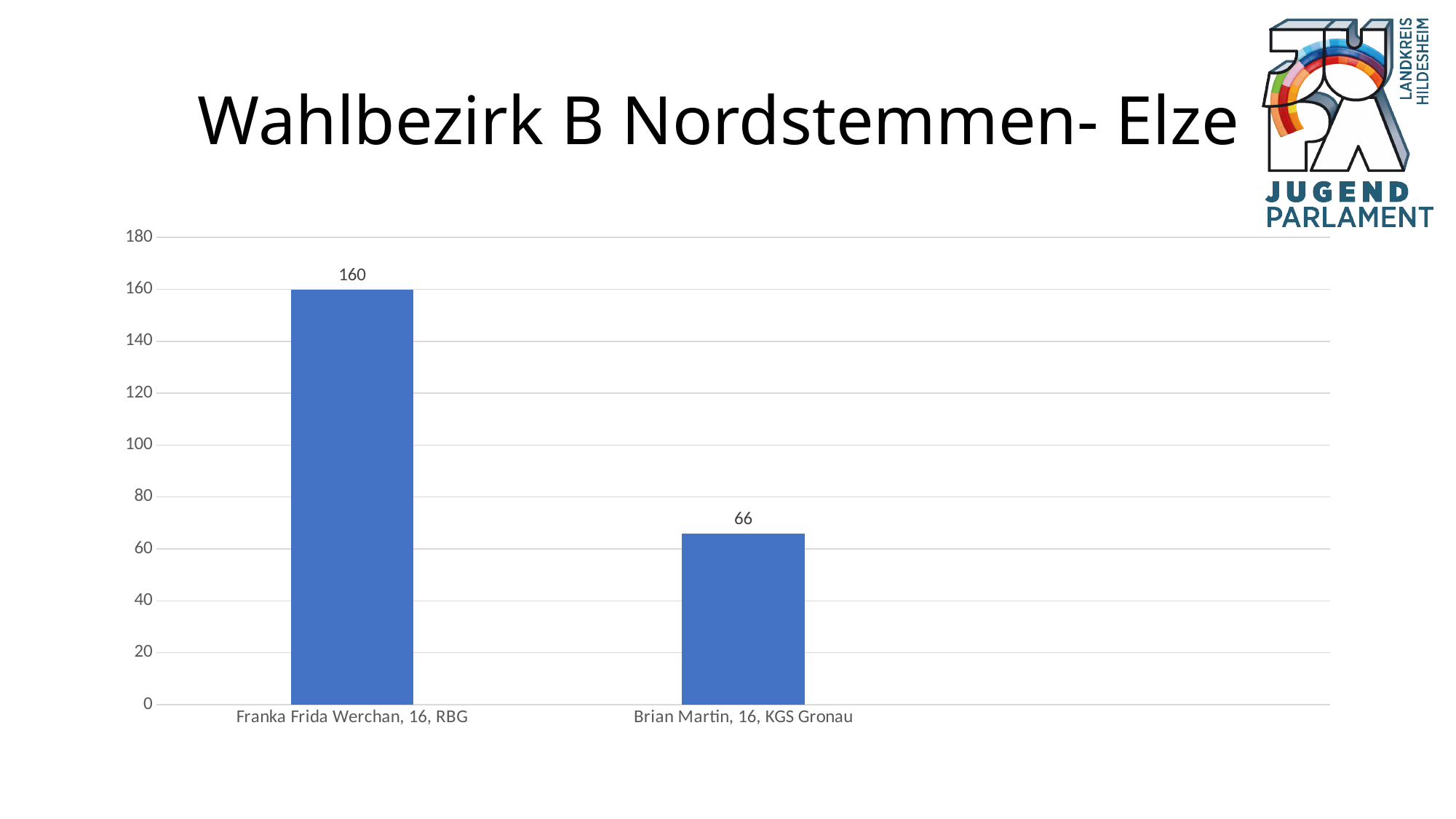
What is the difference between the values for Franka Frida Werchan, 16, RBG and Brian Martin, 16, KGS Gronau? 94 Which category has the lowest value? Brian Martin, 16, KGS Gronau Is the value for Brian Martin, 16, KGS Gronau greater or less than 80? less Is the value for Franka Frida Werchan, 16, RBG greater or less than 140? greater What kind of chart is shown on the slide? bar chart What is the value for Franka Frida Werchan, 16, RBG? 160 How many categories are shown in the chart? 2 Which is larger, the value for Franka Frida Werchan, 16, RBG or the value for Brian Martin, 16, KGS Gronau? Franka Frida Werchan, 16, RBG What is the value for Brian Martin, 16, KGS Gronau? 66 What is the title of the slide? Wahlbezirk B Nordstemmen- Elze What is the highest value shown on the vertical axis? 180 Which category has the highest value? Franka Frida Werchan, 16, RBG